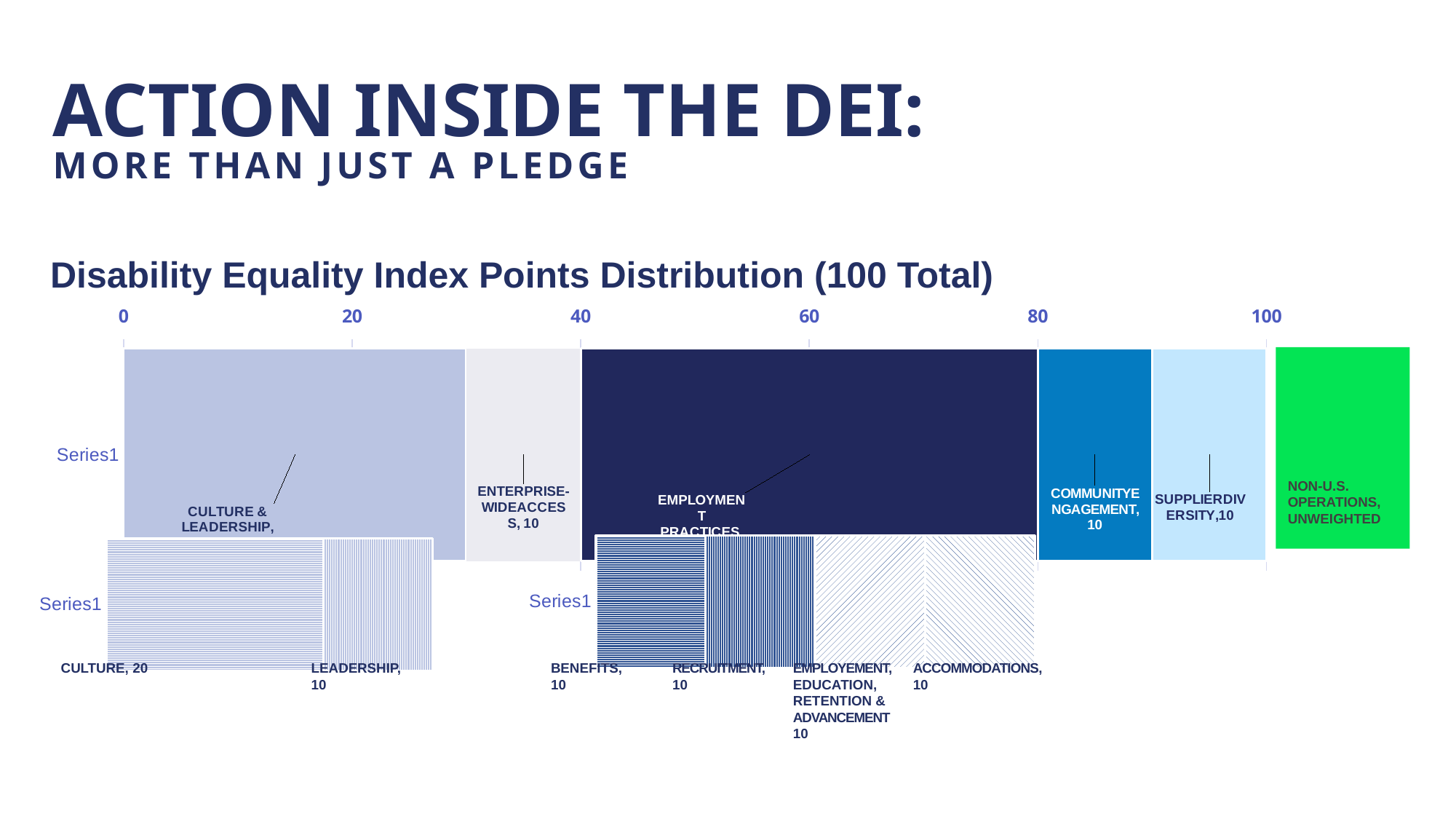
In the main chart, Disability Equality Index Points Distribution, is the value for Employment Practices greater or less than 20? greater In the main chart, Disability Equality Index Points Distribution, is the value for Culture & Leadership greater or less than 20? greater In the bottom-left breakdown chart, how many points are allocated to Culture? 20 In the bottom-left breakdown chart, how many points are allocated to Leadership? 10 In the main chart, Disability Equality Index Points Distribution, how many points are allocated to Enterprise-wide Access? 10 In the main chart, Disability Equality Index Points Distribution, how many points are allocated to Supplier Diversity? 10 In the main chart, Disability Equality Index Points Distribution, how many points are allocated to Community Engagement? 10 In the bottom-left breakdown chart, what is the difference between the Culture and Leadership values? 10 What is the title of the main chart on the slide? Disability Equality Index Points Distribution (100 Total) In the bottom-right breakdown chart, what is the total of the Benefits, Recruitment, Employment/Education/Retention & Advancement, and Accommodations segments? 40 In the main chart, Disability Equality Index Points Distribution, which segment is larger: Employment Practices or Enterprise-wide Access? Employment Practices In the main chart, Disability Equality Index Points Distribution, what kind of chart is shown? bar chart